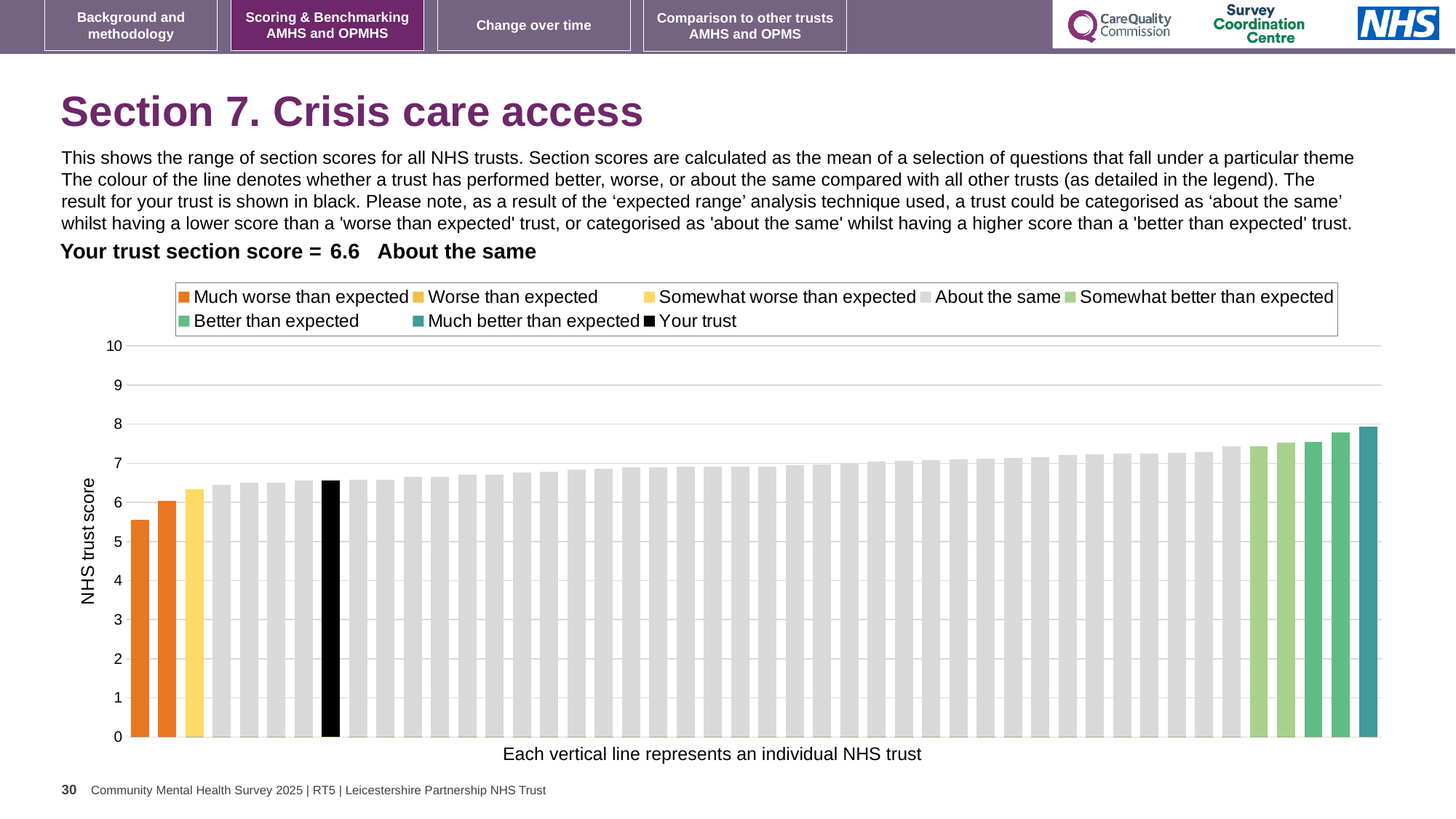
Is the value of the leftmost bar greater or less than 6? less Is the value for your trust greater or less than 7? less Which is larger: the value for your trust (black bar) or the value of the leftmost bar? Your trust Which category is your trust placed in for this section? About the same Is the value of the tallest bar greater or less than 7? greater What kind of chart is shown on the slide? bar chart What is the label on the vertical axis of the chart? NHS trust score How many entries does the chart legend list? 8 Which legend category does the tallest bar belong to? Much better than expected What is the section score for your trust shown on the slide? 6.6 Do the bar values rise or fall from left to right along the x axis? rise How many bars are coloured as 'Much worse than expected'? 2